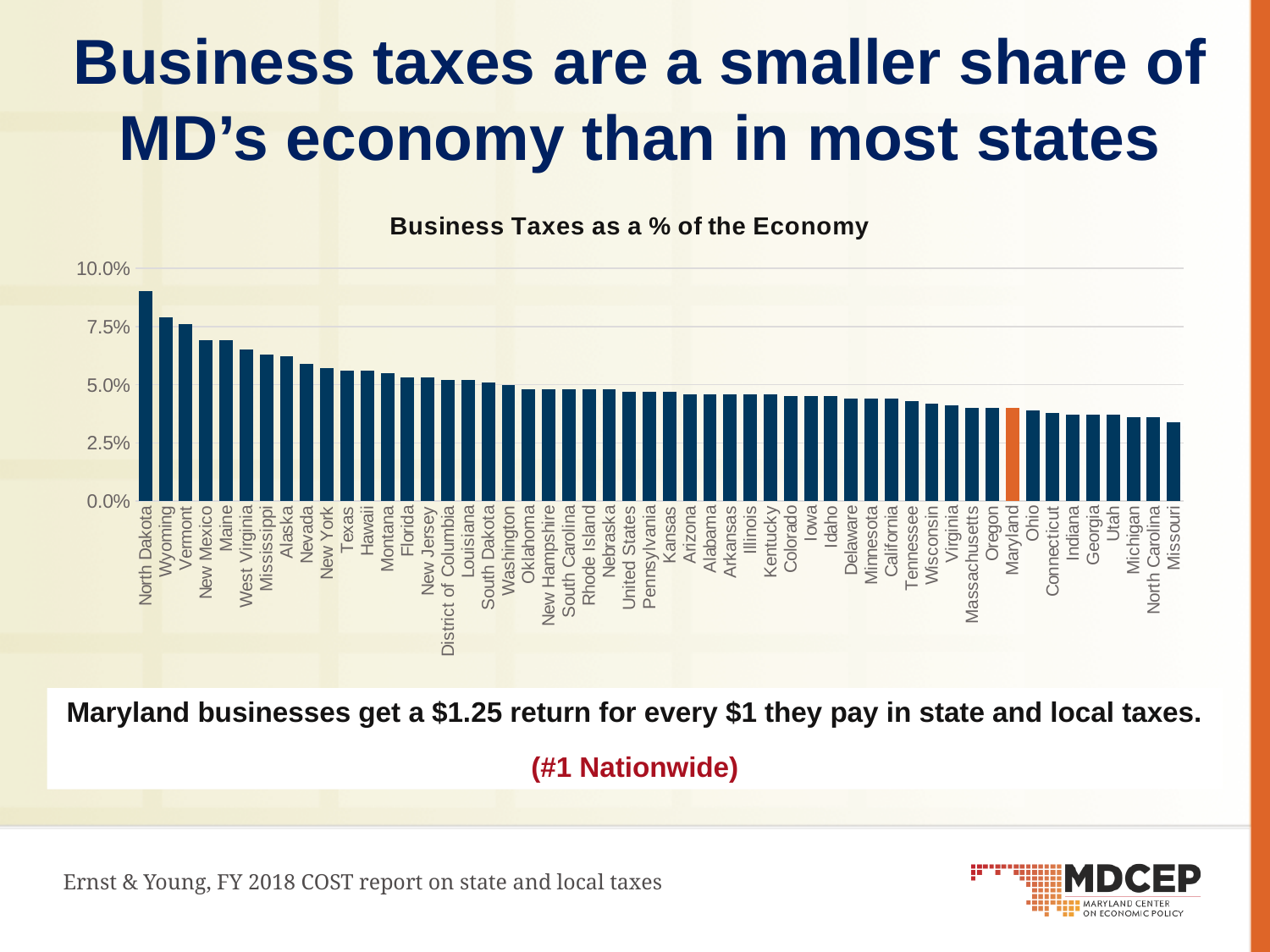
Is the value for North Dakota greater or less than 7.5%? greater Which category has the highest value in the chart? North Dakota Is the value for Maine greater or less than 7.5%? less Is the value for Missouri greater or less than 5.0%? less What is the title of the chart? Business Taxes as a % of the Economy Which category has the lowest value in the chart? Missouri Which bar is highlighted in orange rather than blue? Maryland Which has a larger value, Texas or Maryland? Texas What kind of chart is shown on the slide? bar chart Do the values rise or fall moving from left to right along the x axis? fall